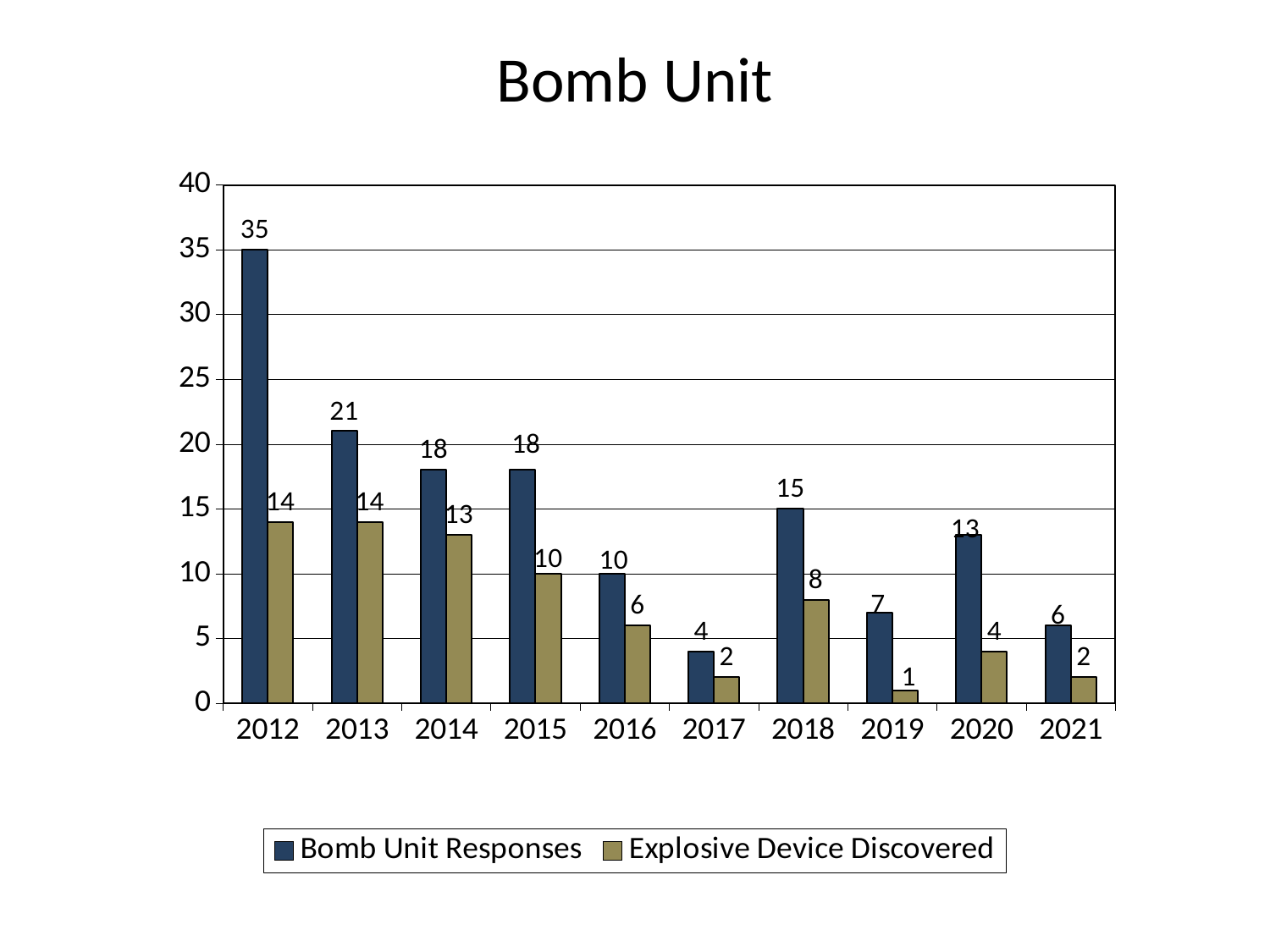
What is the difference between Bomb Unit Responses and Explosive Device Discovered in 2018? 7 Which is larger: Bomb Unit Responses in 2020 or Bomb Unit Responses in 2019? 2020 Which year has the highest value for Bomb Unit Responses? 2012 What is the value of Bomb Unit Responses in 2012? 35 What kind of chart is shown on the slide? bar chart How many series does the legend list? 2 Which year has the lowest value for Explosive Device Discovered? 2019 What is the value of Explosive Device Discovered in 2019? 1 Is the value for Bomb Unit Responses in 2013 greater or less than 20? greater How many years are shown on the x axis? 10 What is the title of the chart? Bomb Unit Do the Bomb Unit Responses values generally rise or fall from 2012 to 2017? fall